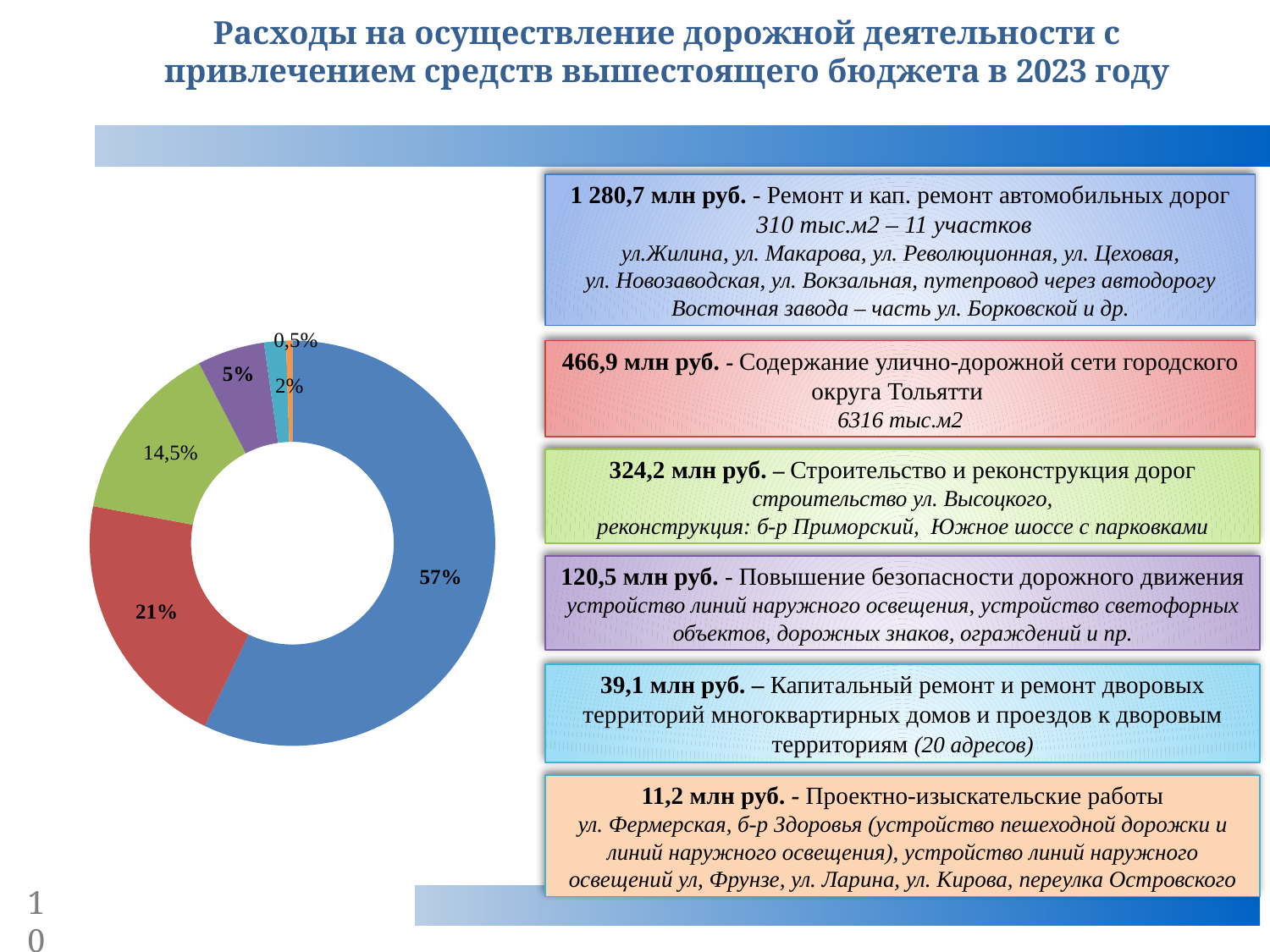
What share does the light blue (cyan) slice of the doughnut chart represent? 2% What share does the purple slice of the doughnut chart represent? 5% How many slices does the doughnut chart have? 6 What kind of chart is shown on the slide? Doughnut (pie) chart What share does the green slice of the doughnut chart represent? 14,5% Which slice is larger: the green slice or the purple slice? The green slice (14,5%) What share does the red slice of the doughnut chart represent? 21% What is the combined share of the two smallest slices (2% and 0,5%)? 2,5% What is the largest share shown on the doughnut chart? 57% Which expense item, according to the colour-matched text boxes, corresponds to the 57% slice? Ремонт и кап. ремонт автомобильных дорог (1 280,7 млн руб.) What is the difference in percentage points between the blue slice (57%) and the red slice (21%)? 36 percentage points What is the smallest share shown on the doughnut chart? 0,5%